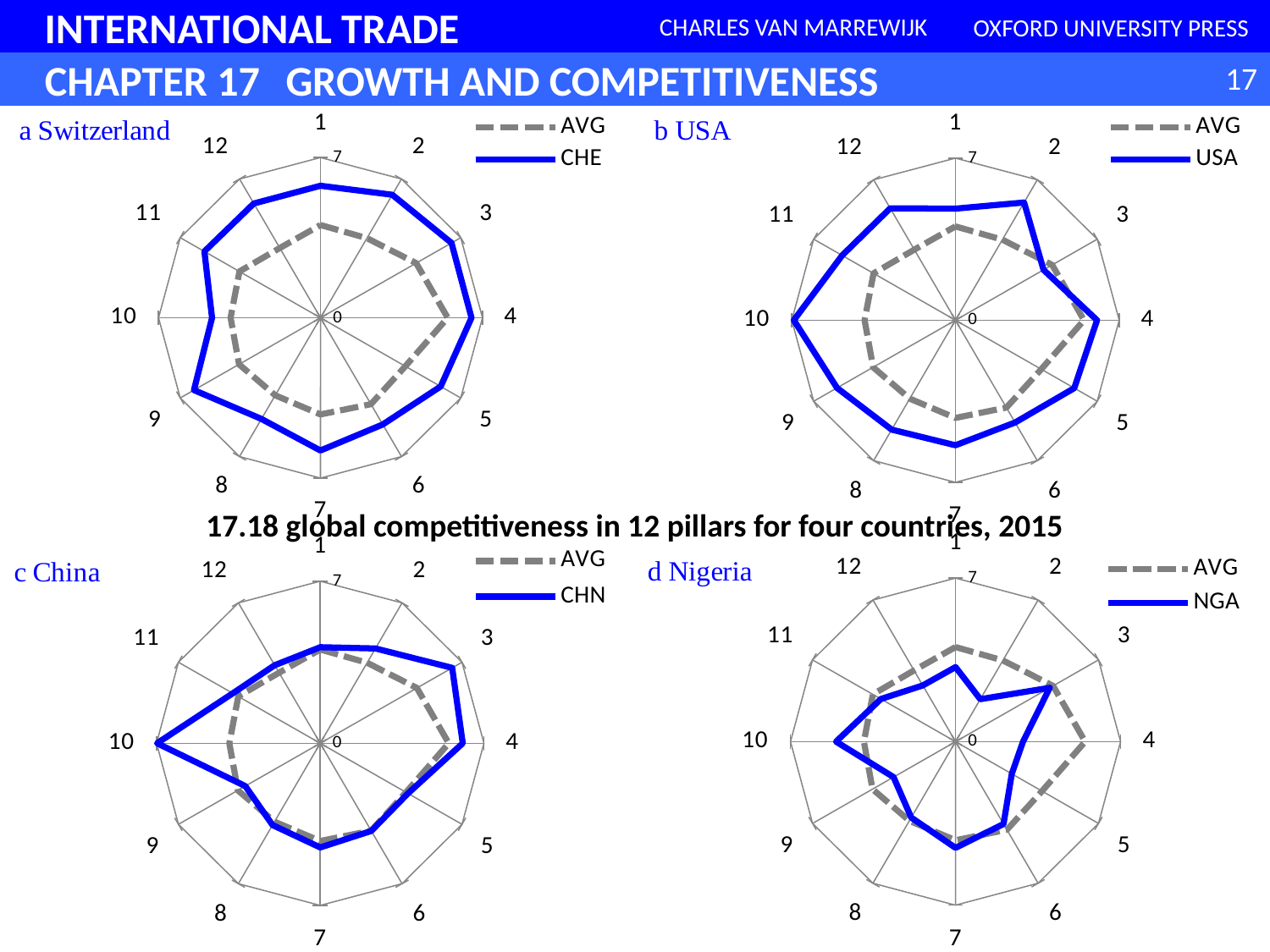
On the Switzerland chart (a), which is larger at pillar 1, CHE or AVG? CHE On the China chart (c), which is larger at pillar 10, CHN or AVG? CHN What kind of chart is used for the Switzerland panel (a)? Radar chart What are the two legend entries on the Nigeria chart (d)? AVG and NGA What is the title printed beneath the top two charts? 17.18 global competitiveness in 12 pillars for four countries, 2015 How many series does the legend of the China chart (c) list? 2 On the Nigeria chart (d), which is larger at pillar 1, NGA or AVG? AVG What is the maximum value shown on the radial axis of the Switzerland chart (a)? 7 How many pillars (categories) are plotted on the USA radar chart (b)? 12 On the China chart (c), at which pillar does CHN reach its highest value? 10